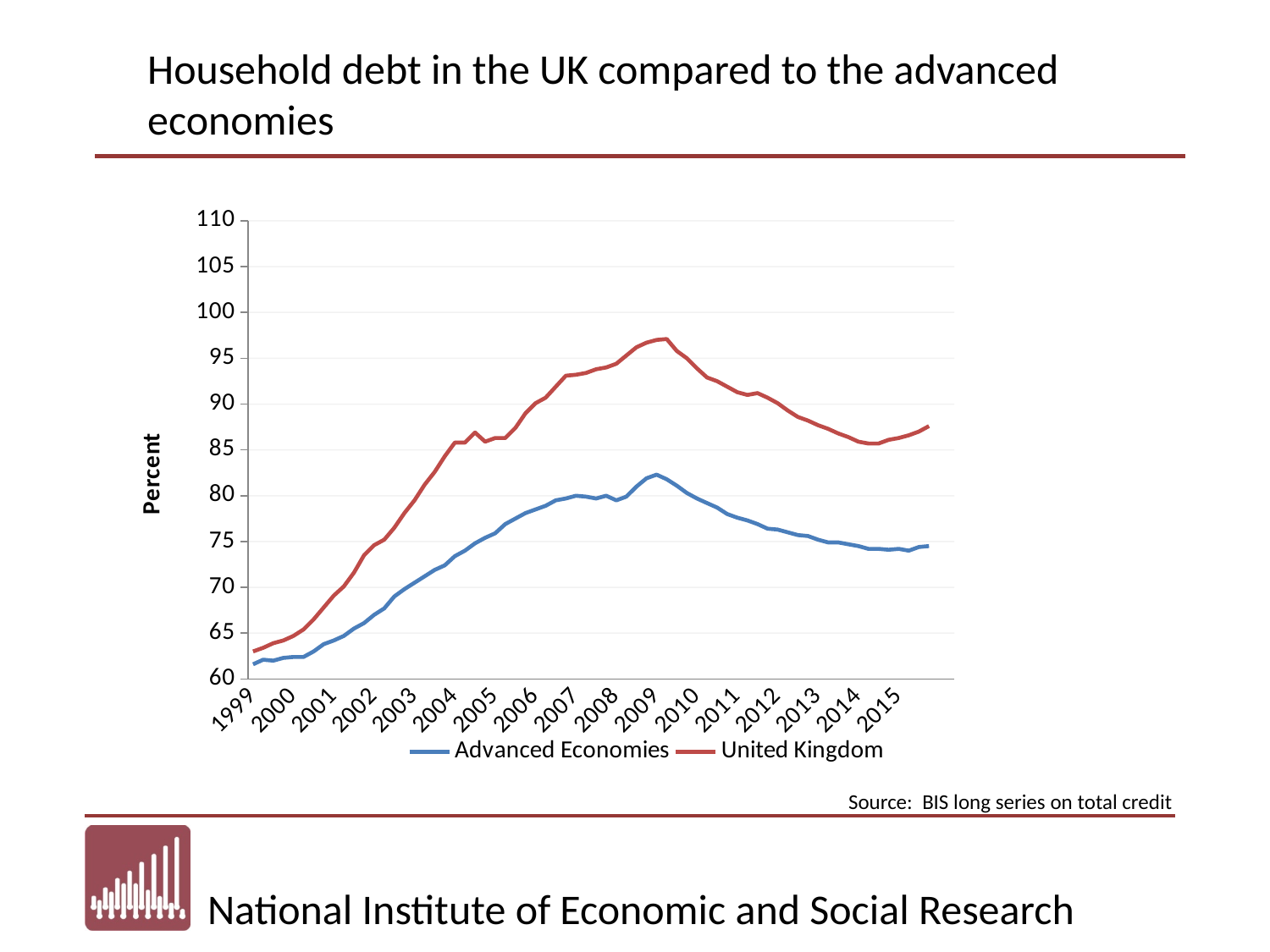
Is the value for the United Kingdom in 1999 greater or less than 65? less What is the label on the vertical axis? Percent Is the peak value for the United Kingdom greater or less than 95? greater Does the Advanced Economies series rise or fall between 2009 and 2015? fall How many series does the legend list? 2 What are the two series named in the legend? Advanced Economies and United Kingdom Does the United Kingdom series rise or fall between 1999 and 2009? rise Is the value for Advanced Economies in 2015 greater or less than 75? less Which series has the higher values throughout the period shown? United Kingdom What kind of chart is shown on the slide? line chart In which year does the Advanced Economies series reach its highest value? 2009